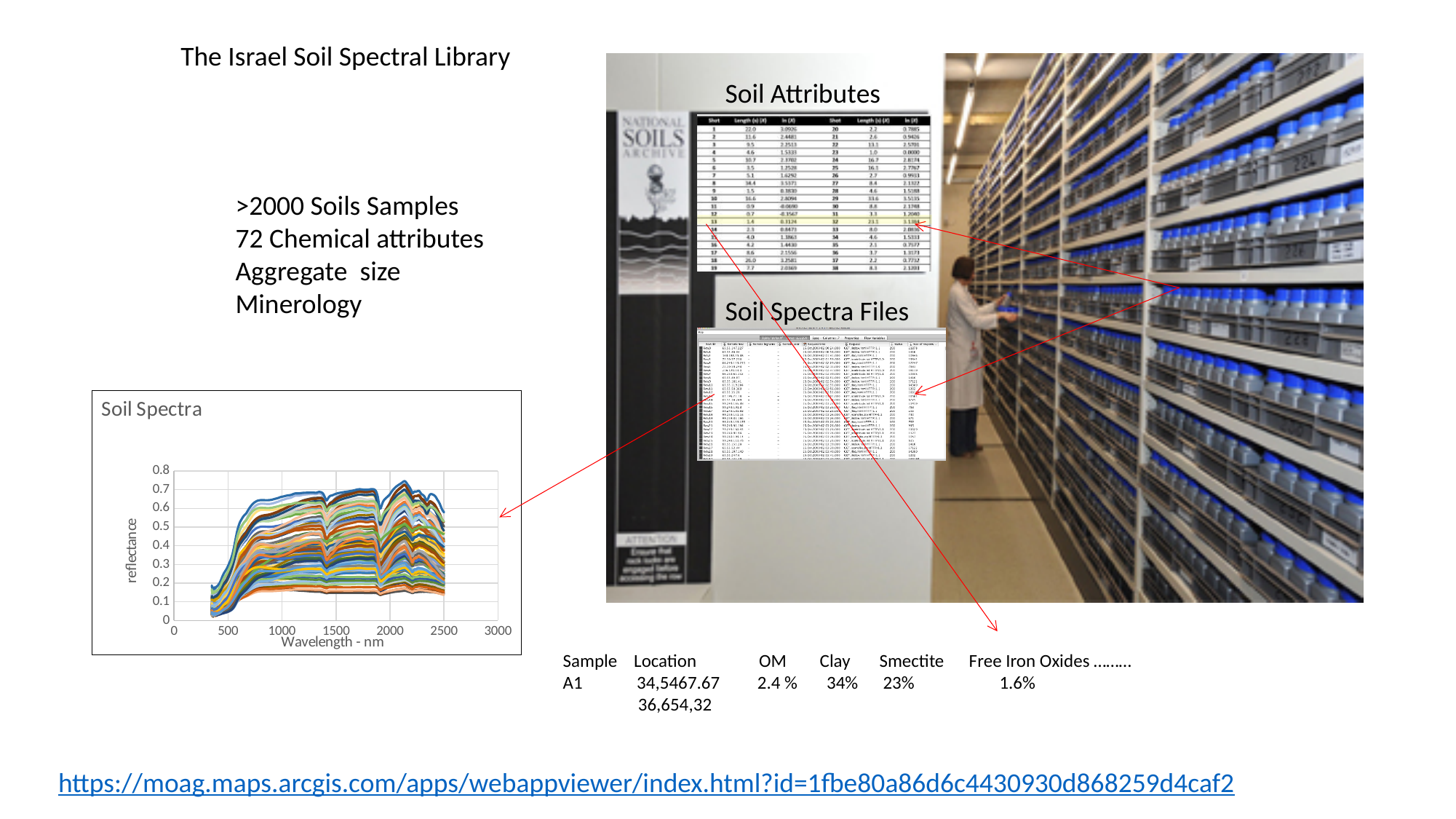
What is the highest tick value shown on the x axis of the "Soil Spectra" chart? 3000 What is the label of the x axis of the "Soil Spectra" chart? Wavelength - nm In the "Soil Spectra" chart, is the highest reflectance reached by any line greater or less than 0.8? less In the "Soil Spectra" chart, is the lowest reflectance of the lines at 500 nm greater or less than 0.3? less What is the highest tick value shown on the y axis of the "Soil Spectra" chart? 0.8 In the "Soil Spectra" chart, is the highest reflectance reached by any line greater or less than 0.6? greater In the "Soil Spectra" chart, do the reflectance lines rise or fall between about 400 nm and 800 nm? rise In the "Soil Spectra" chart, do the lines extend beyond 2500 nm on the x axis? No What kind of chart is the "Soil Spectra" chart? line chart What is the title of the chart on the slide? Soil Spectra